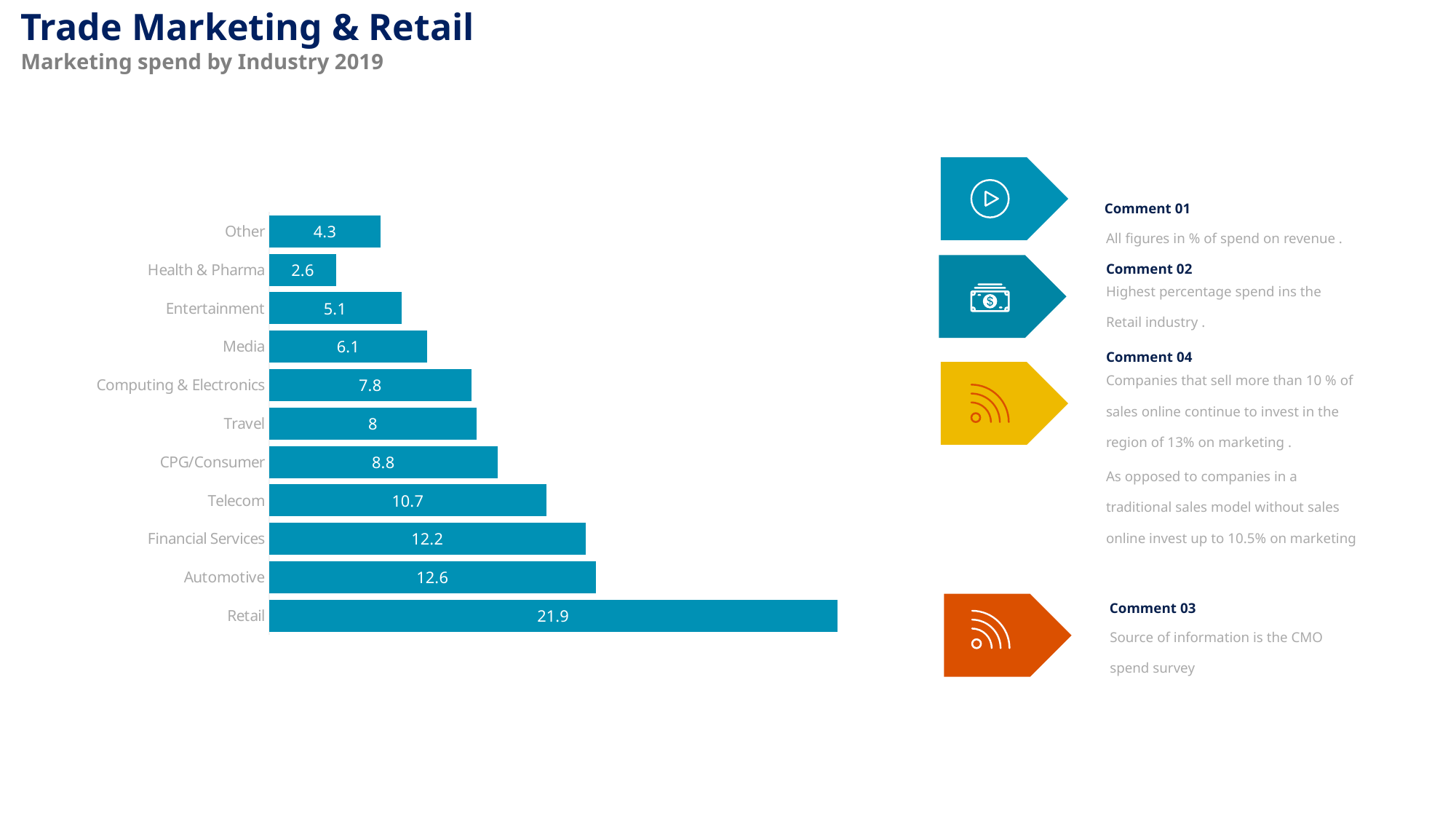
Which industry has the lowest value? Health & Pharma How many industries are shown in the chart? 11 What is the value for Health & Pharma? 2.6 Which is larger, the value for Media or the value for Entertainment? Media What is the difference between the values for Retail and Telecom? 11.2 Which industry has the highest value? Retail What is the difference between the values for Automotive and Financial Services? 0.4 What is the value for Travel? 8 What is the value for Computing & Electronics? 7.8 What is the value for Retail? 21.9 What kind of chart is shown on the slide? Bar chart What is the value for Telecom? 10.7